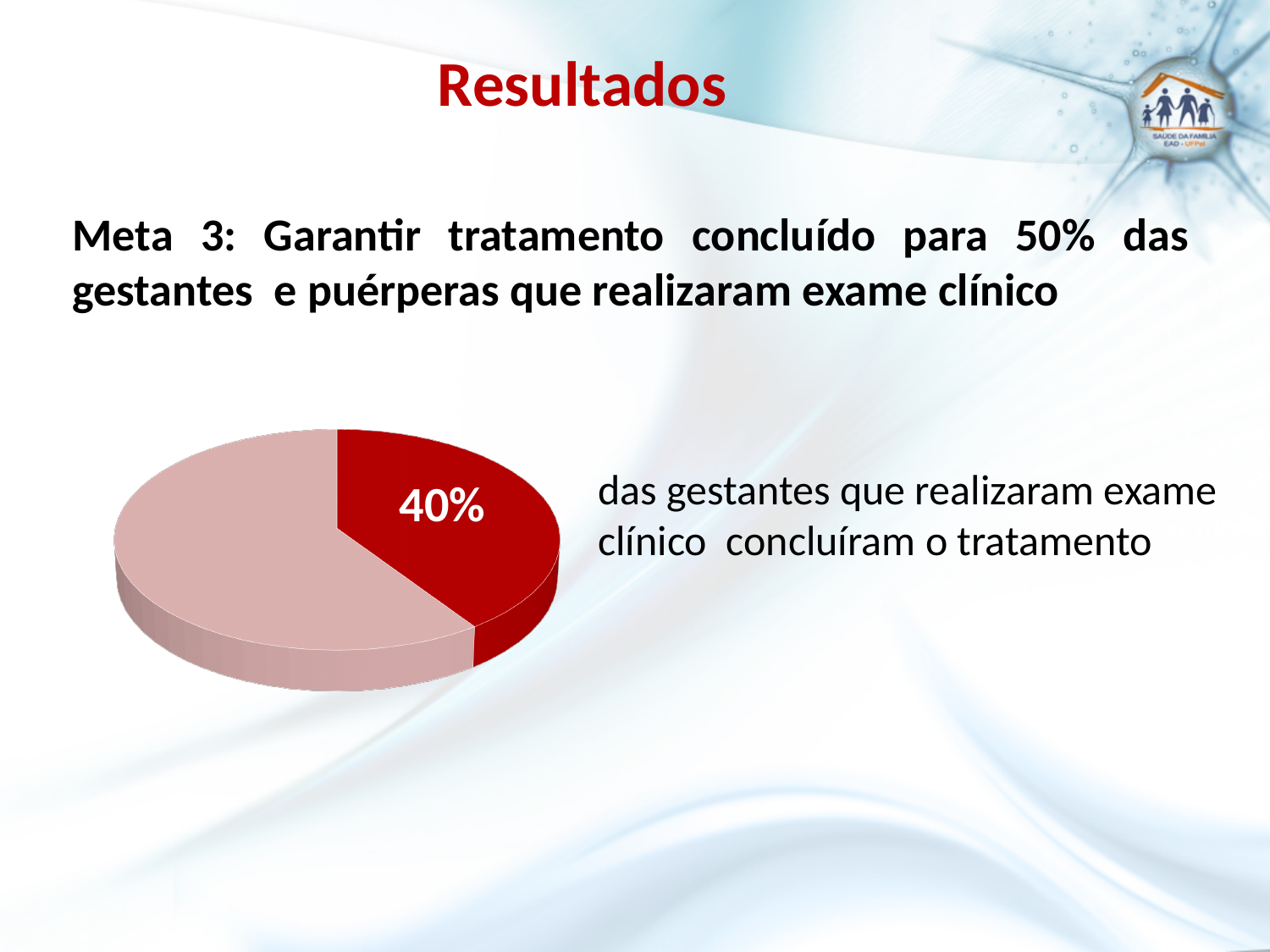
What percentage is printed on the dark red slice of the pie chart? 40% How many slices does the pie chart have? 2 What share of the pie does the dark red slice represent? 40% Does the pie chart have a legend? No What kind of chart is shown on the slide? pie chart Which slice of the pie chart is larger, the dark red one or the light pink one? the light pink one Which slice of the pie chart is the smallest? the dark red slice (40%) What is the title at the top of the slide containing the pie chart? Resultados